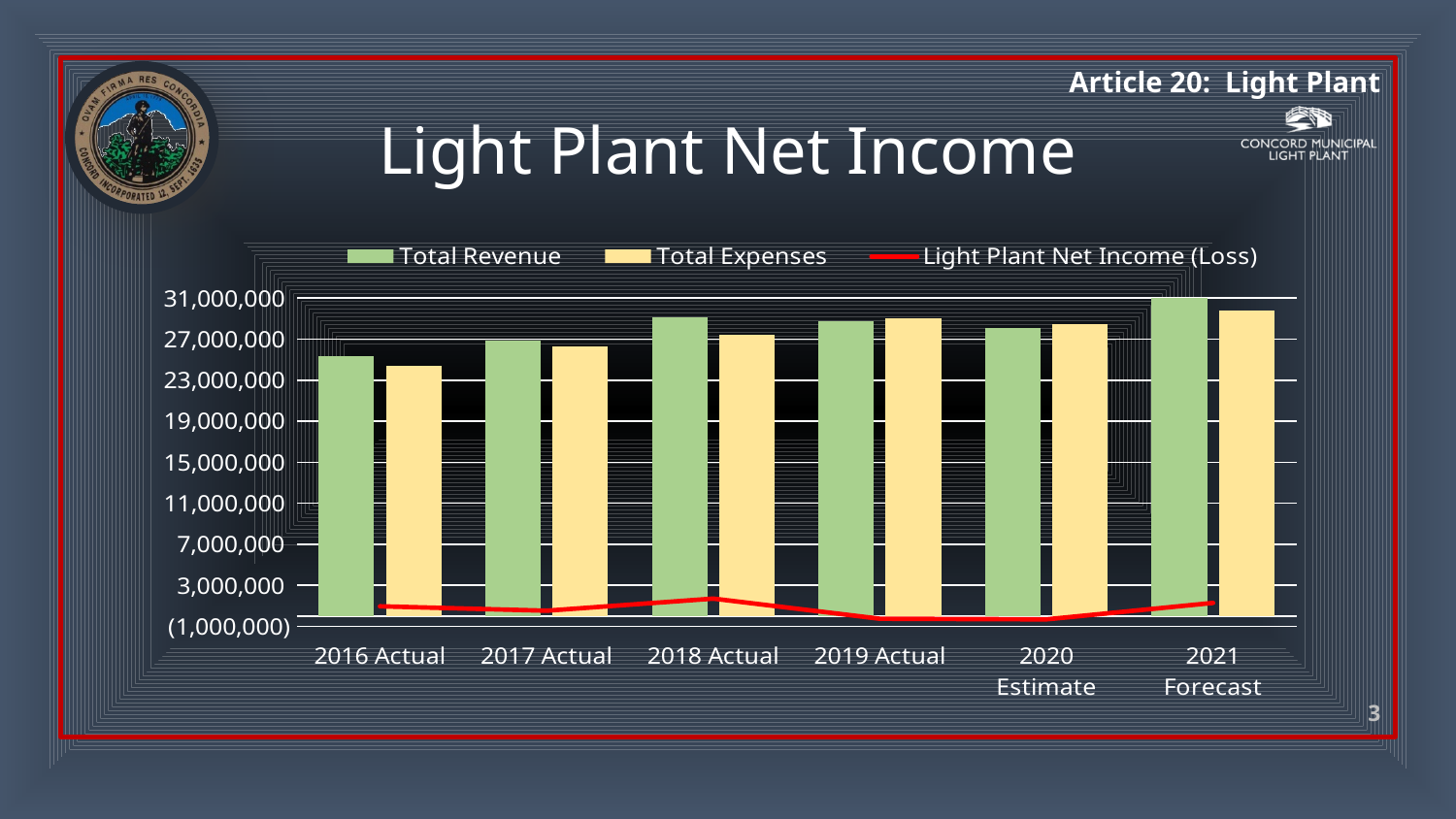
Which category has the lowest Total Revenue? 2016 Actual What is the title of the chart? Light Plant Net Income How many categories are shown on the x axis? 6 Is the Total Revenue for 2016 Actual greater or less than 23,000,000? greater Which category has the highest Total Revenue? 2021 Forecast Is the Total Revenue for 2018 Actual greater or less than 27,000,000? greater What kind of chart is shown on the slide? combination bar and line chart For 2018 Actual, which is larger: Total Revenue or Total Expenses? Total Revenue For 2016 Actual, which is larger: Total Revenue or Total Expenses? Total Revenue Which category has the lowest Total Expenses? 2016 Actual Is the Total Expenses value for 2017 Actual greater or less than 27,000,000? less How many series does the legend list? 3